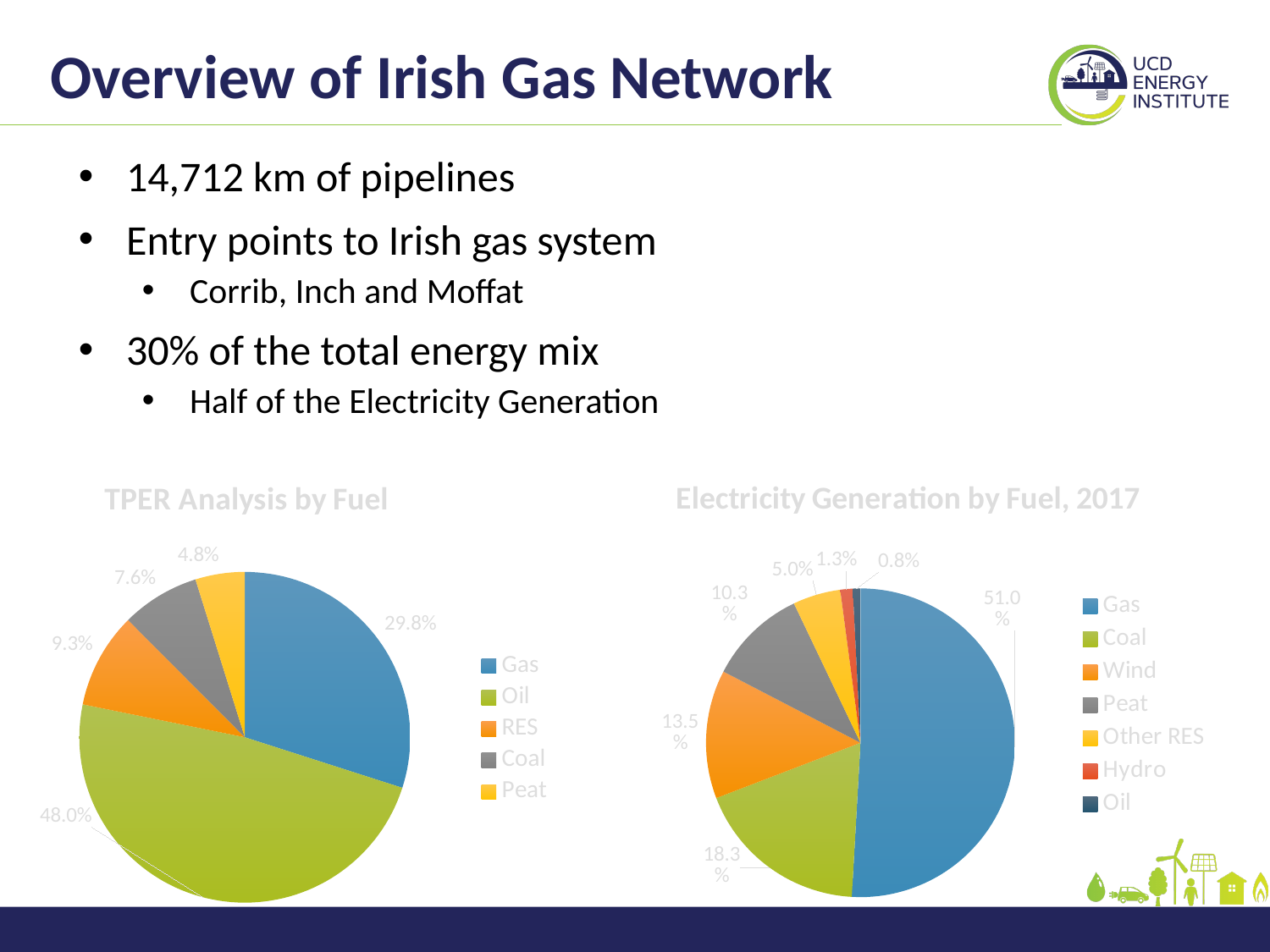
In the Electricity Generation by Fuel, 2017 chart, what share does Gas have? 51.0% How many fuel categories does the legend of the TPER Analysis by Fuel chart list? 5 In the Electricity Generation by Fuel, 2017 chart, which is larger, the share of Coal or the share of Peat? Coal In the TPER Analysis by Fuel chart, what share does Oil have? 48.0% In the Electricity Generation by Fuel, 2017 chart, what share does Wind have? 13.5% In the TPER Analysis by Fuel chart, which fuel has the smallest share? Peat In the Electricity Generation by Fuel, 2017 chart, what is the difference between the shares of Gas and Coal? 32.7% What type of chart is the Electricity Generation by Fuel, 2017 chart? Pie chart In the Electricity Generation by Fuel, 2017 chart, which fuel has the smallest share? Oil In the TPER Analysis by Fuel chart, what share does Gas have? 29.8% In the TPER Analysis by Fuel chart, what is the difference between the shares of RES and Coal? 1.7% In the TPER Analysis by Fuel chart, which fuel has the largest share? Oil